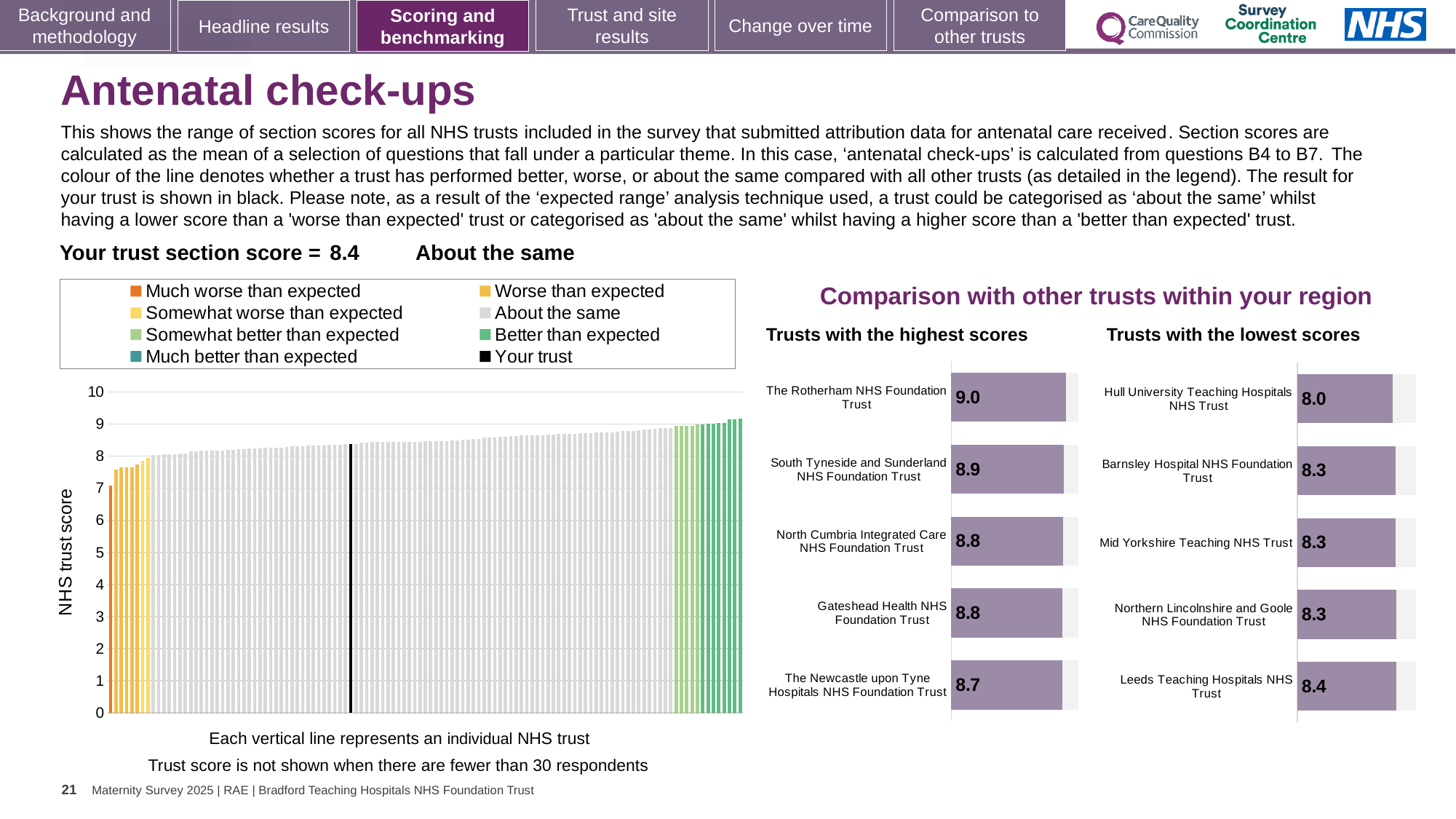
In the 'Trusts with the highest scores' chart, what is the difference between the scores of The Rotherham NHS Foundation Trust and The Newcastle upon Tyne Hospitals NHS Foundation Trust? 0.3 In the 'Trusts with the lowest scores' chart, which has the larger score: Hull University Teaching Hospitals NHS Trust or Leeds Teaching Hospitals NHS Trust? Leeds Teaching Hospitals NHS Trust In the 'Trusts with the lowest scores' chart, what is the score for Hull University Teaching Hospitals NHS Trust? 8.0 In the 'Trusts with the lowest scores' chart, which trust has the lowest score? Hull University Teaching Hospitals NHS Trust In the large chart on the left showing all NHS trusts, what kind of chart is it? Bar chart In the large chart on the left showing all NHS trusts, do the trust scores rise or fall from left to right? Rise In the 'Trusts with the lowest scores' chart, what is the difference between the scores of Leeds Teaching Hospitals NHS Trust and Hull University Teaching Hospitals NHS Trust? 0.4 In the 'Trusts with the highest scores' chart, what is the score for The Rotherham NHS Foundation Trust? 9.0 In the 'Trusts with the highest scores' chart, which trust has the highest score? The Rotherham NHS Foundation Trust In the 'Trusts with the highest scores' chart, what is the score for The Newcastle upon Tyne Hospitals NHS Foundation Trust? 8.7 In the large chart on the left showing all NHS trusts, how many entries does the legend list? 8 In the 'Trusts with the highest scores' chart, how many trusts are shown? 5